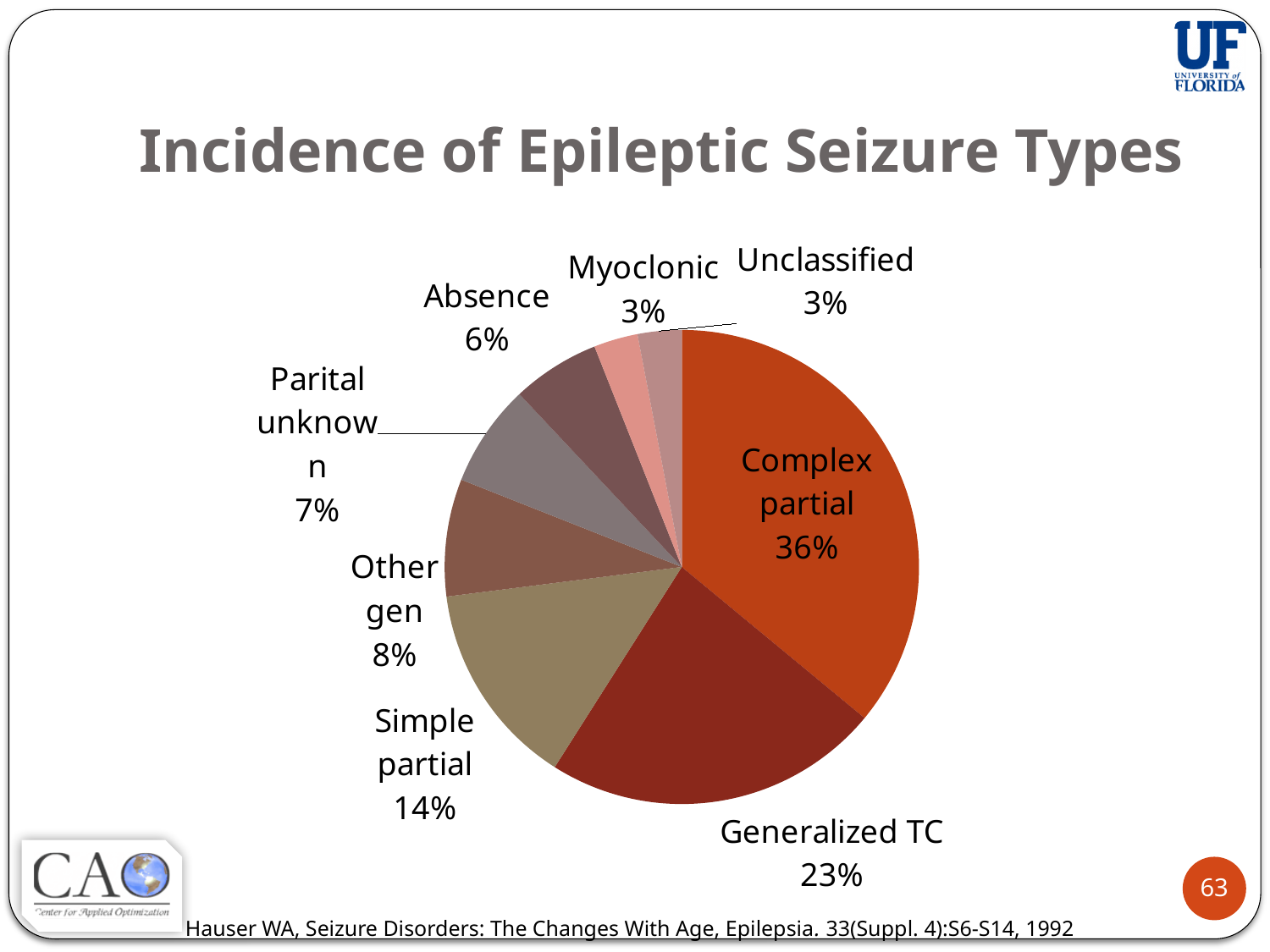
What is the difference between Simple partial and Absence? 8% What share of the pie does Complex partial represent? 36% Which seizure type has the largest slice of the pie? Complex partial What is the title of the chart? Incidence of Epileptic Seizure Types How many slices does the pie chart have? 8 Which is larger, Other gen or Parital unknown? Other gen What is the value shown for Generalized TC? 23% What is the difference between the Complex partial and Generalized TC percentages? 13% What is the value shown for Myoclonic? 3% What is the value shown for Simple partial? 14% What type of chart is shown on the slide? pie chart What is the value shown for Absence? 6%